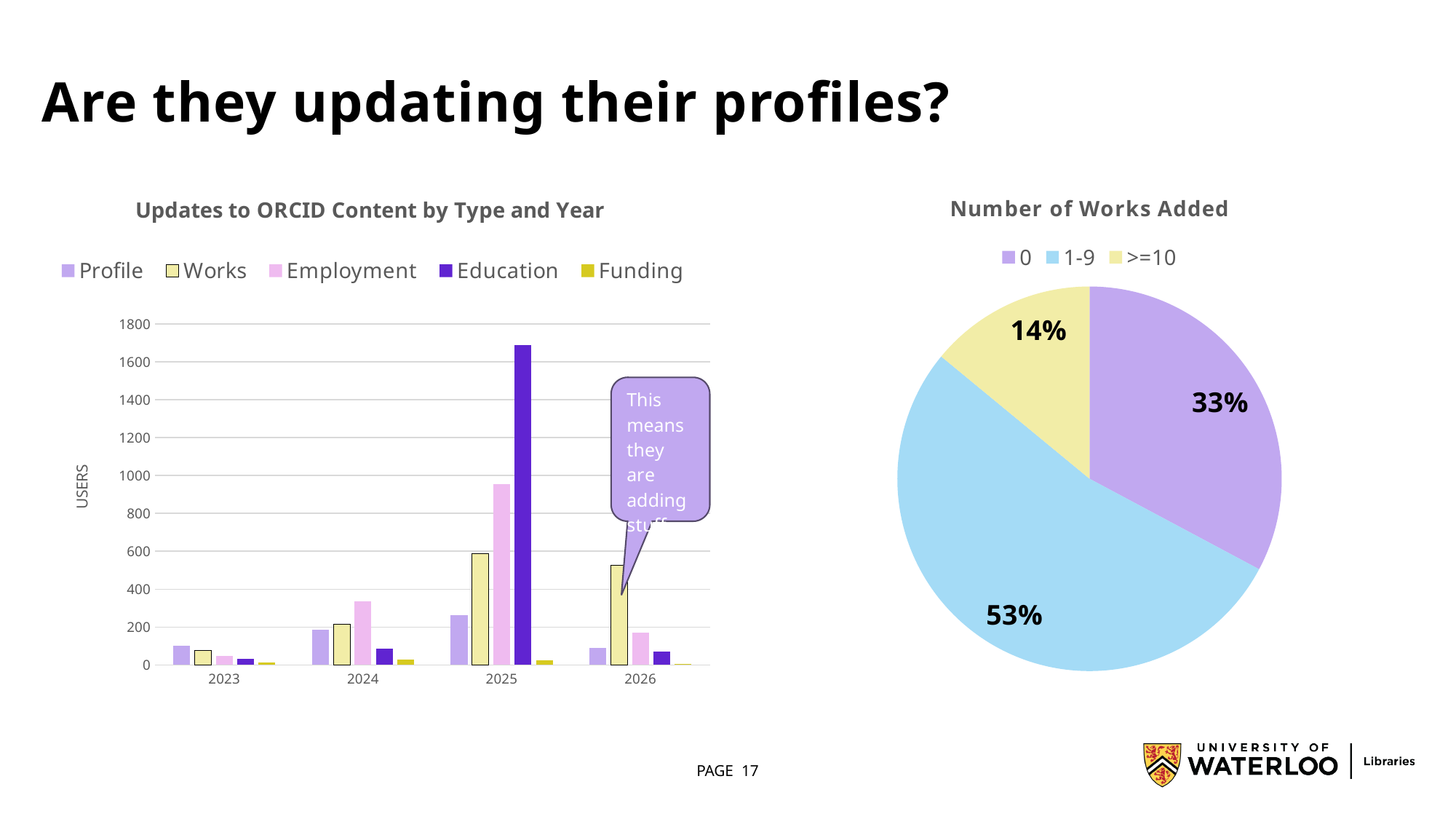
In the 'Updates to ORCID Content by Type and Year' chart, which series has the lowest value in 2025? Funding In the 'Number of Works Added' pie chart, what is the difference between the '1-9' share and the '0' share? 20% In the 'Updates to ORCID Content by Type and Year' chart, how many years are shown on the x axis? 4 In the 'Number of Works Added' pie chart, what share is shown for the '1-9' slice? 53% In the 'Number of Works Added' pie chart, which category has the smallest slice? >=10 What kind of chart is 'Updates to ORCID Content by Type and Year'? bar chart In the 'Updates to ORCID Content by Type and Year' chart, what is the label on the vertical axis? USERS In the 'Updates to ORCID Content by Type and Year' chart, is the Education value for 2025 greater or less than 1600? greater In the 'Updates to ORCID Content by Type and Year' chart, how many series does the legend list? 5 In the 'Updates to ORCID Content by Type and Year' chart, which is larger in 2025: Works or Employment? Employment In the 'Updates to ORCID Content by Type and Year' chart, which series has the highest value in 2025? Education